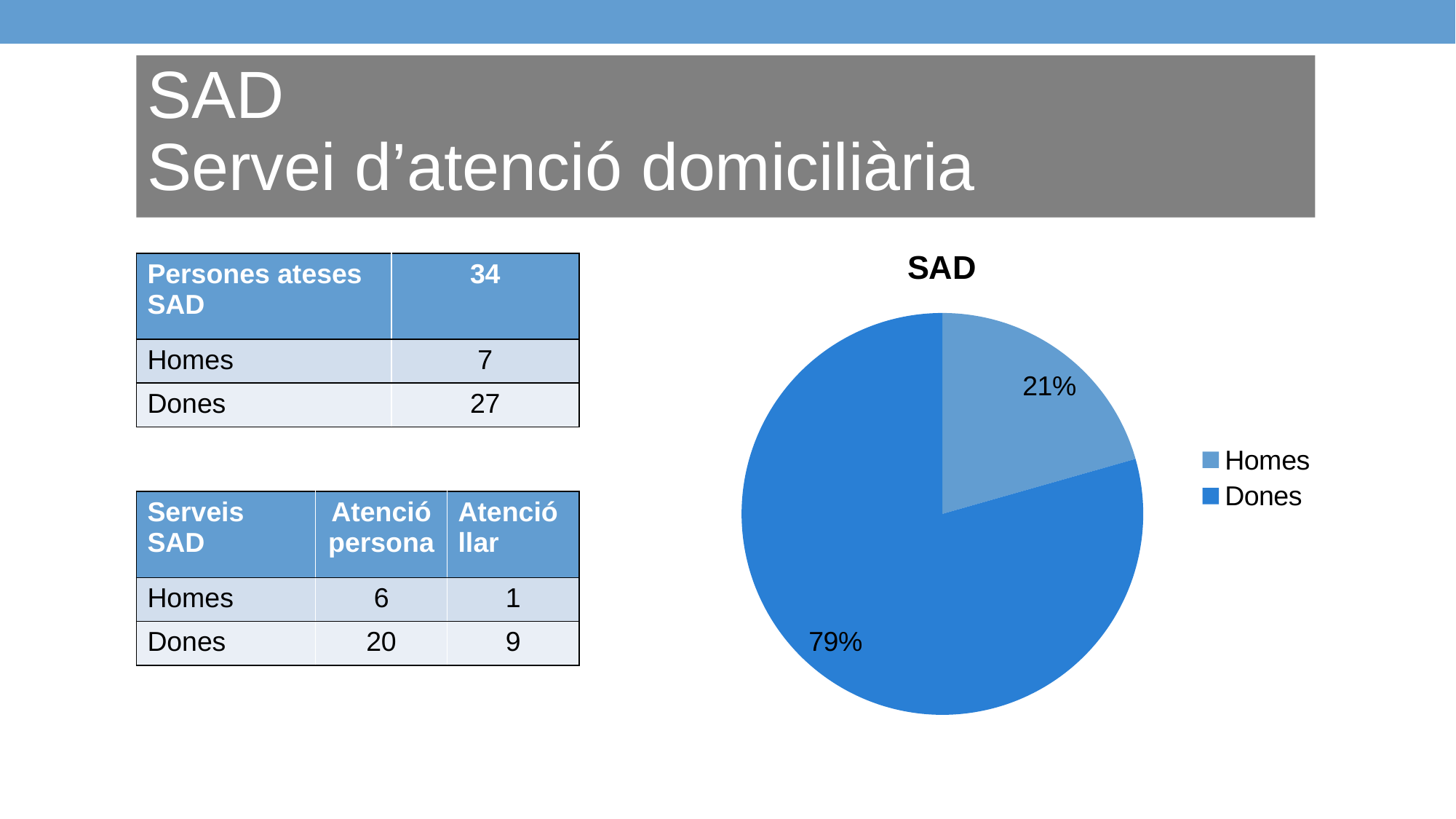
What share of the pie does Dones represent? 79% What share of the pie does Homes represent? 21% What is the difference in percentage points between the Dones slice and the Homes slice? 58 What kind of chart is shown on the slide? pie chart What is the title of the chart? SAD How many slices does the pie chart have? 2 Which legend entry is shown in the darker blue colour? Dones Which slice of the pie is the smallest? Homes Which is larger, the Homes slice or the Dones slice? Dones How many entries does the legend list? 2 Which slice of the pie is the largest? Dones